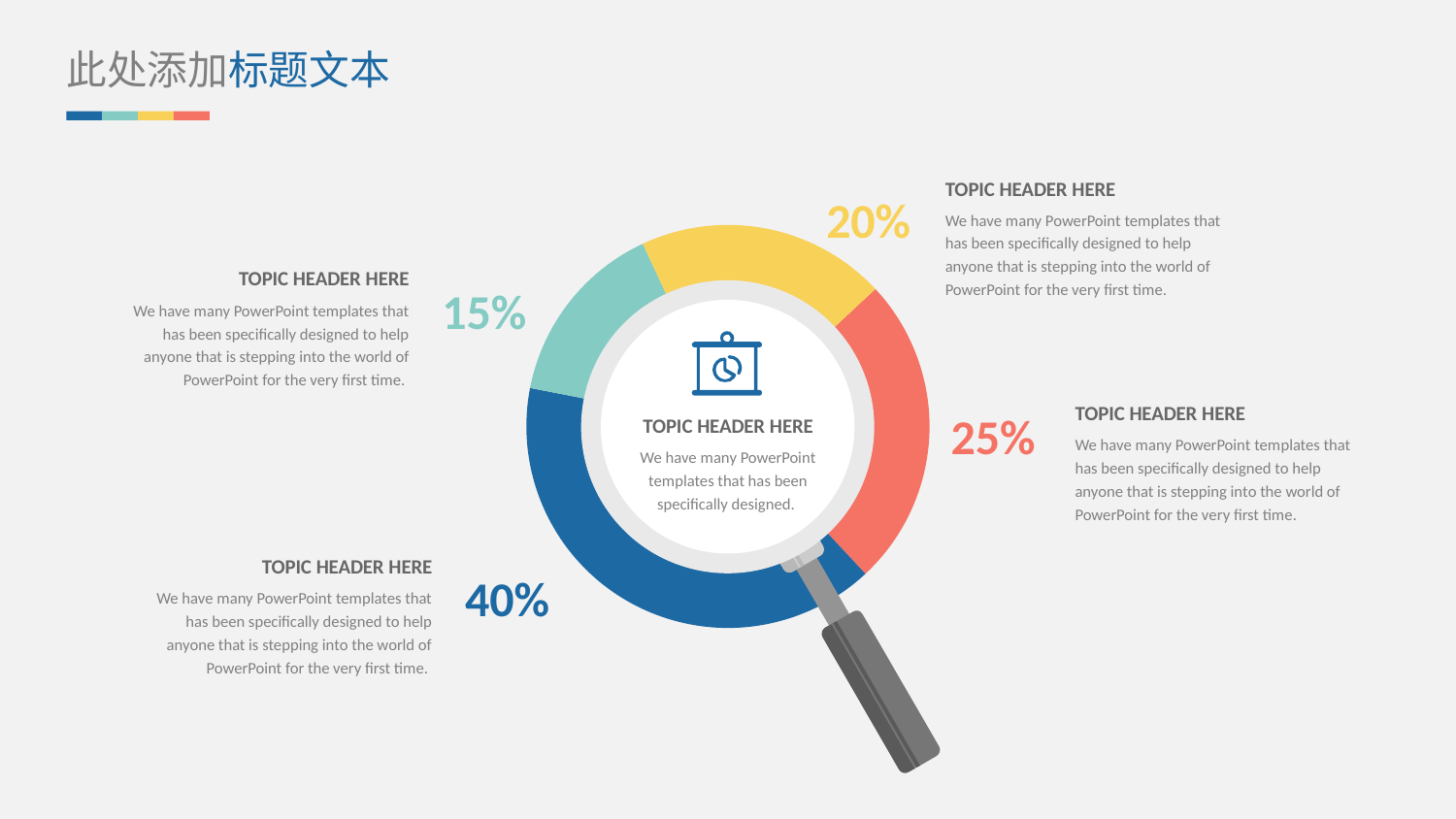
What kind of chart is shown on the slide? Pie chart (donut) How many slices does the donut chart have? 4 What percentage is shown for the teal slice of the donut chart? 15% Which slice of the donut chart has the largest share? The blue slice (40%) What percentage is shown for the blue slice of the donut chart? 40% What text appears in the centre of the donut chart as its header? TOPIC HEADER HERE Which slice of the donut chart has the smallest share? The teal slice (15%) What percentage is shown for the red slice of the donut chart? 25% What percentage is shown for the yellow slice of the donut chart? 20% What do the four percentages in the donut chart add up to? 100% Which is larger in the donut chart, the yellow slice or the red slice? The red slice (25%) What is the difference between the blue slice and the red slice in the donut chart? 15%